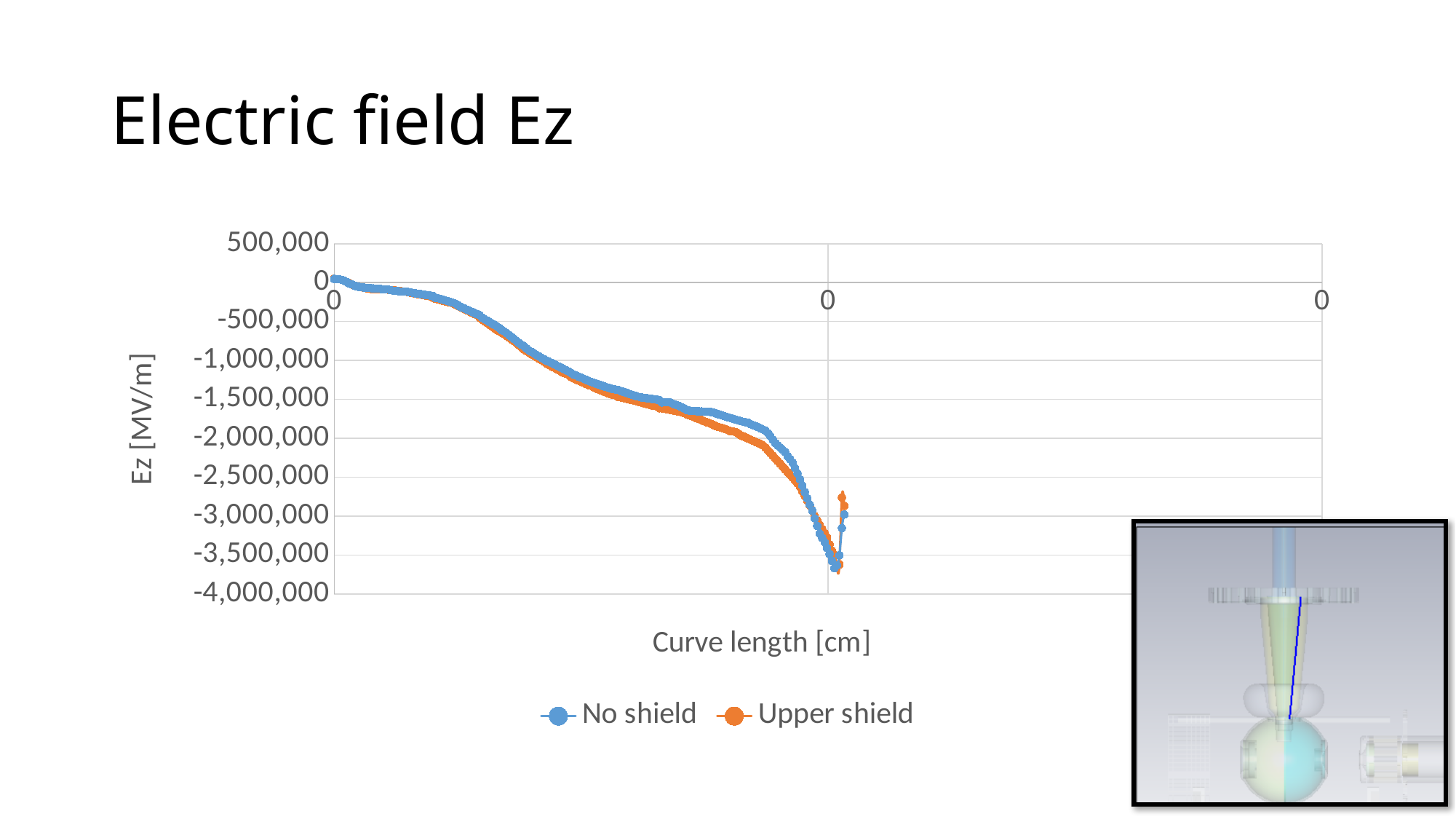
What is the lowest value shown on the y axis? -4,000,000 Is the lowest Ez value reached by the Upper shield series greater or less than -3,500,000? less What are the two series named in the legend? No shield and Upper shield How many series does the legend list? 2 Is the Ez value at the start of the No shield series greater or less than -500,000? greater Is the lowest Ez value reached by the No shield series greater or less than -3,000,000? less Do the Ez values for the Upper shield series mainly rise or fall as curve length increases? fall What kind of chart is shown on the slide? line chart What is the title of the chart's y axis? Ez [MV/m] Do the Ez values for the No shield series mainly rise or fall as curve length increases? fall